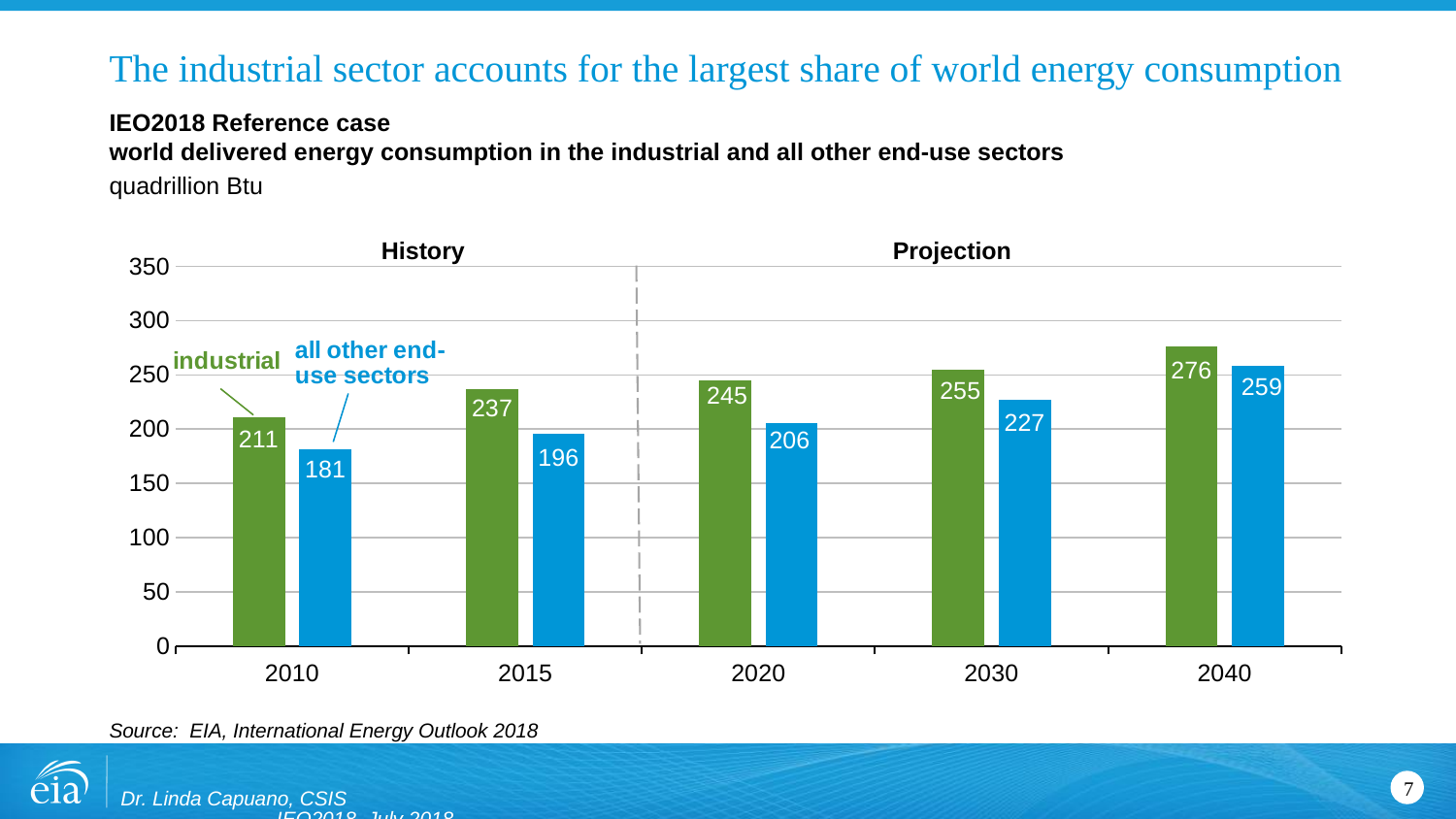
Which is larger in 2015, the industrial sector or all other end-use sectors? industrial What is the industrial sector's value in 2040? 276 What kind of chart is shown on the slide? bar chart Does the industrial sector's consumption rise or fall from 2010 to 2040? rise How many series does the chart show? 2 What is the value for all other end-use sectors in 2030? 227 Is the industrial sector's value in 2030 greater or less than 250? greater In which year is the value for all other end-use sectors lowest? 2010 How many years are shown on the x axis? 5 What is the difference between the industrial and all other end-use sectors values in 2020? 39 What is the industrial sector's energy consumption in 2010? 211 In which year is the industrial sector's consumption highest? 2040